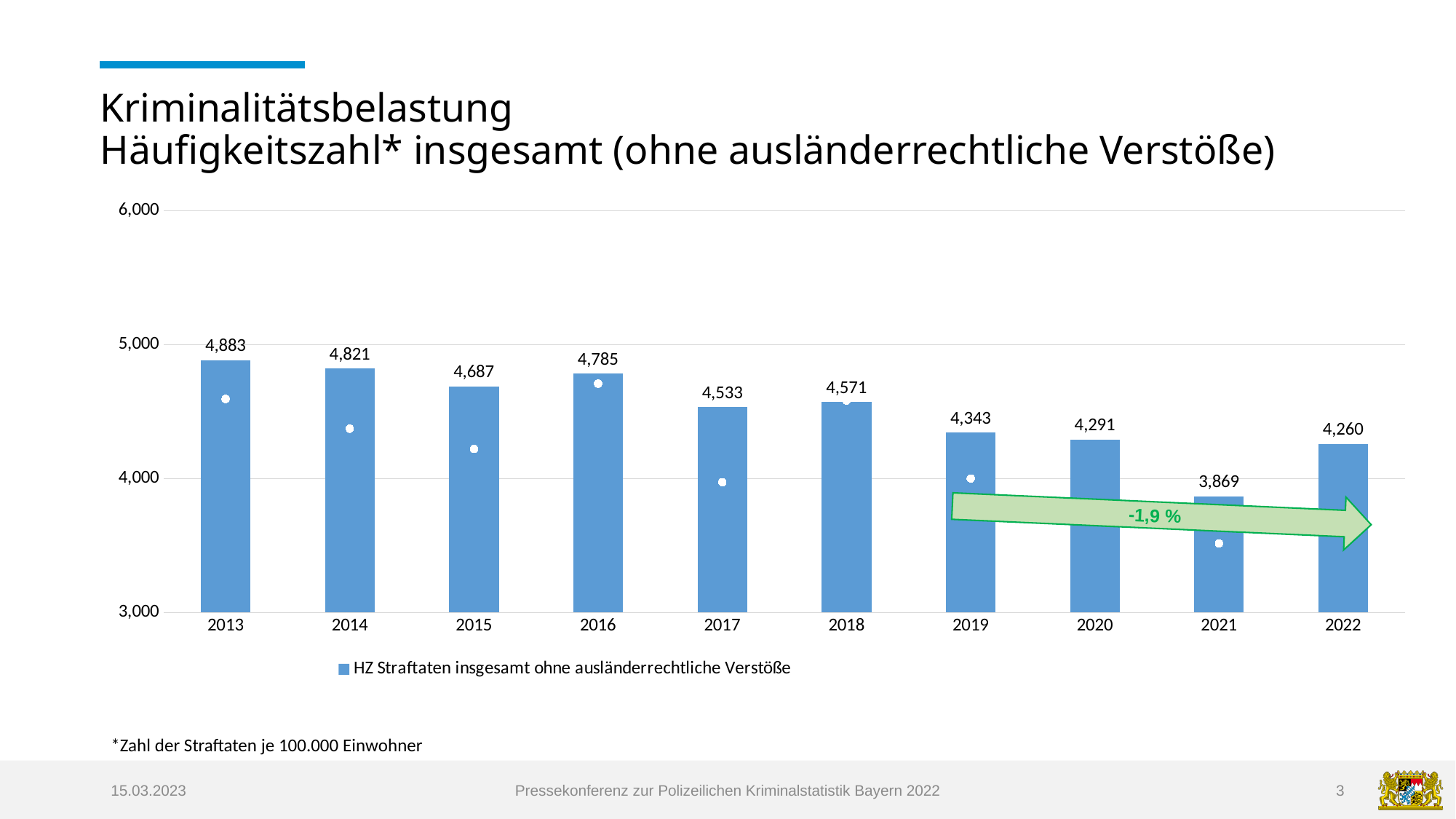
What percentage change is shown on the green arrow? -1,9 % How many years are shown on the x axis? 10 What kind of chart is shown? bar chart What is the difference between the values for 2013 and 2022? 623 What is the value for 2022? 4,260 Is the value for 2021 greater or less than 4,000? less Which is larger, the value for 2016 or the value for 2015? 2016 Which year has the lowest value? 2021 What is the difference between the values for 2021 and 2022? 391 What is the value for 2013? 4,883 Which year has the highest value? 2013 What is the value for 2017? 4,533